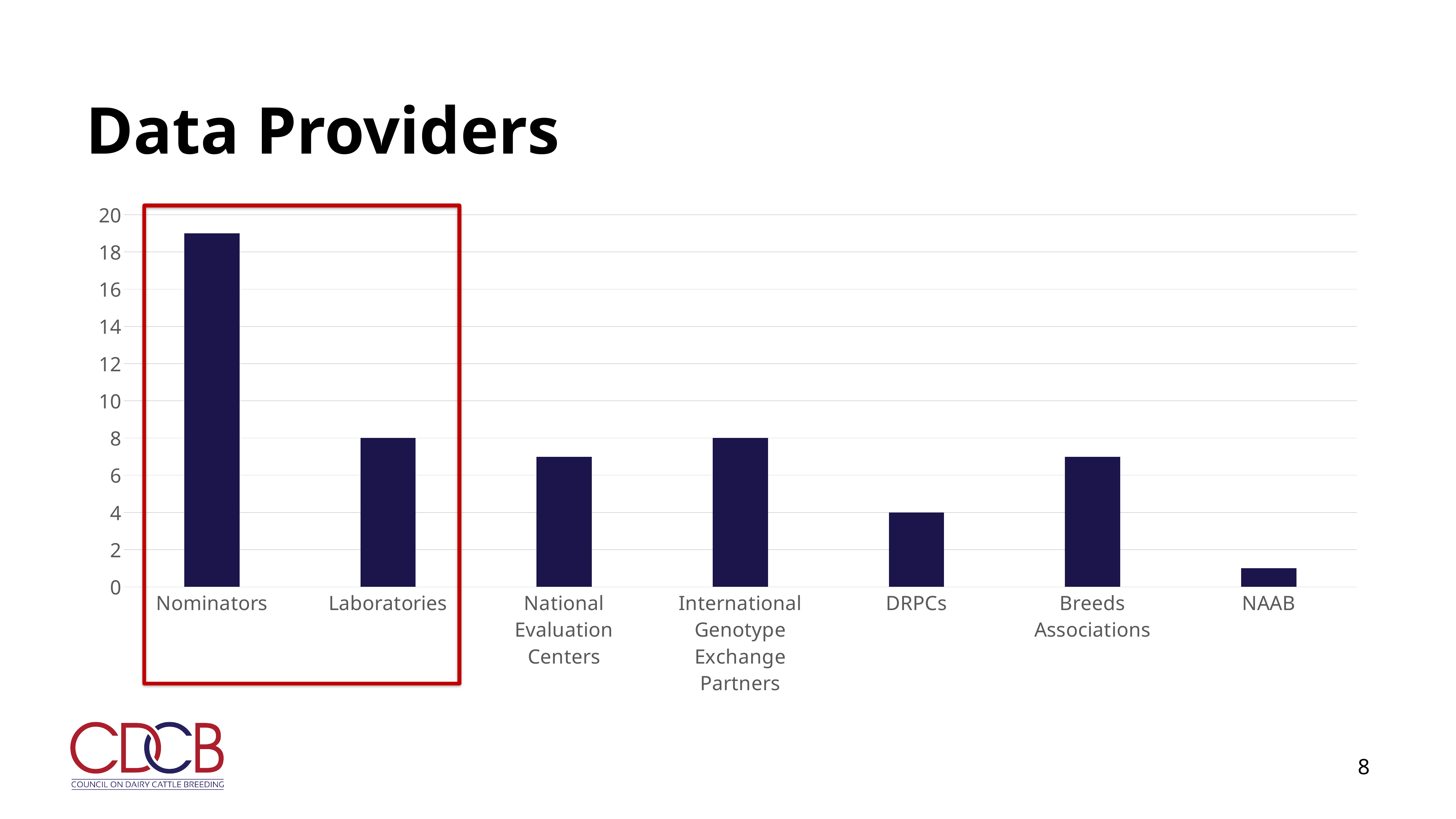
Is the value for NAAB greater or less than 2? less What kind of chart is shown on the slide? bar chart Which category has the lowest bar? NAAB What is the value for International Genotype Exchange Partners? 8 What is the title of the chart? Data Providers What is the value for DRPCs? 4 What is the difference between the values for Laboratories and DRPCs? 4 Is the value for Nominators greater or less than 18? greater Which categories are enclosed by the red box on the chart? Nominators and Laboratories What is the value for Laboratories? 8 Which category has the highest bar? Nominators How many categories are plotted on the x axis? 7